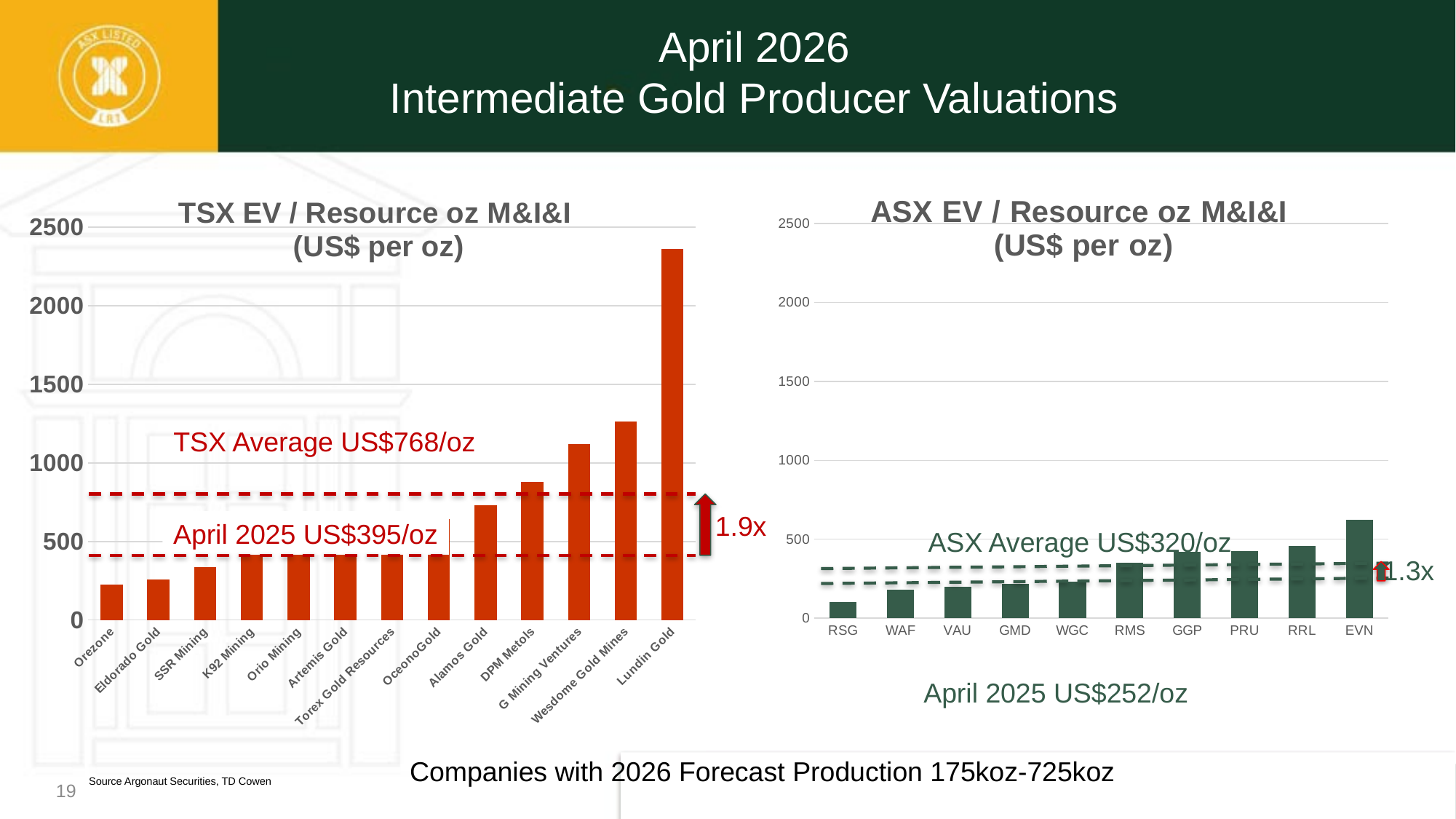
On the ASX EV / Resource oz M&I&I chart, which company has the lowest value? RSG How many companies are shown on the ASX EV / Resource oz M&I&I chart? 10 On the TSX EV / Resource oz M&I&I chart, is the value for Lundin Gold greater or less than 2000? greater On the TSX EV / Resource oz M&I&I chart, which company has the lowest value? Orezone On the ASX EV / Resource oz M&I&I chart, which company has the highest value? EVN On the TSX EV / Resource oz M&I&I chart, which is larger, the value for Alamos Gold or the value for Orezone? Alamos Gold How many companies are shown on the TSX EV / Resource oz M&I&I chart? 13 On the ASX EV / Resource oz M&I&I chart, is the value for RSG greater or less than 500? less On the TSX EV / Resource oz M&I&I chart, which company has the highest value? Lundin Gold On the ASX EV / Resource oz M&I&I chart, is the value for EVN greater or less than 500? greater What kind of chart is the ASX EV / Resource oz M&I&I chart? bar chart